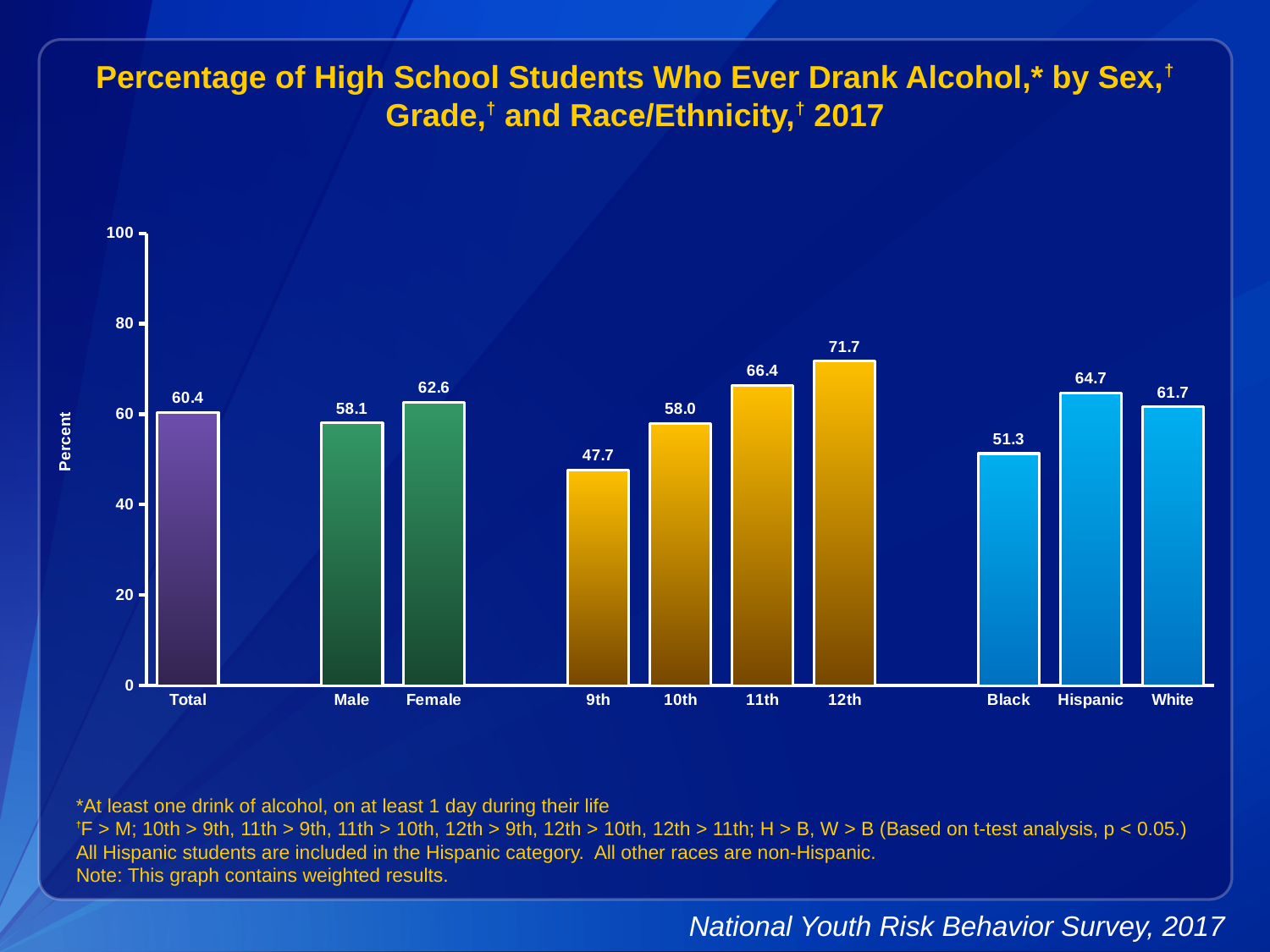
What is the value for Female? 62.6 What is the difference between the values for 12th and 9th grade? 24.0 What is the value for Hispanic? 64.7 What is the difference between the values for Female and Male? 4.5 Which category has the lowest value? 9th What is the value for Total? 60.4 Which is larger, the value for White or the value for Black? White What kind of chart is shown on the slide? bar chart What is the value for 9th grade? 47.7 Which category has the highest value? 12th How many bars are shown in the chart? 10 Is the value for 11th grade greater or less than 60? greater